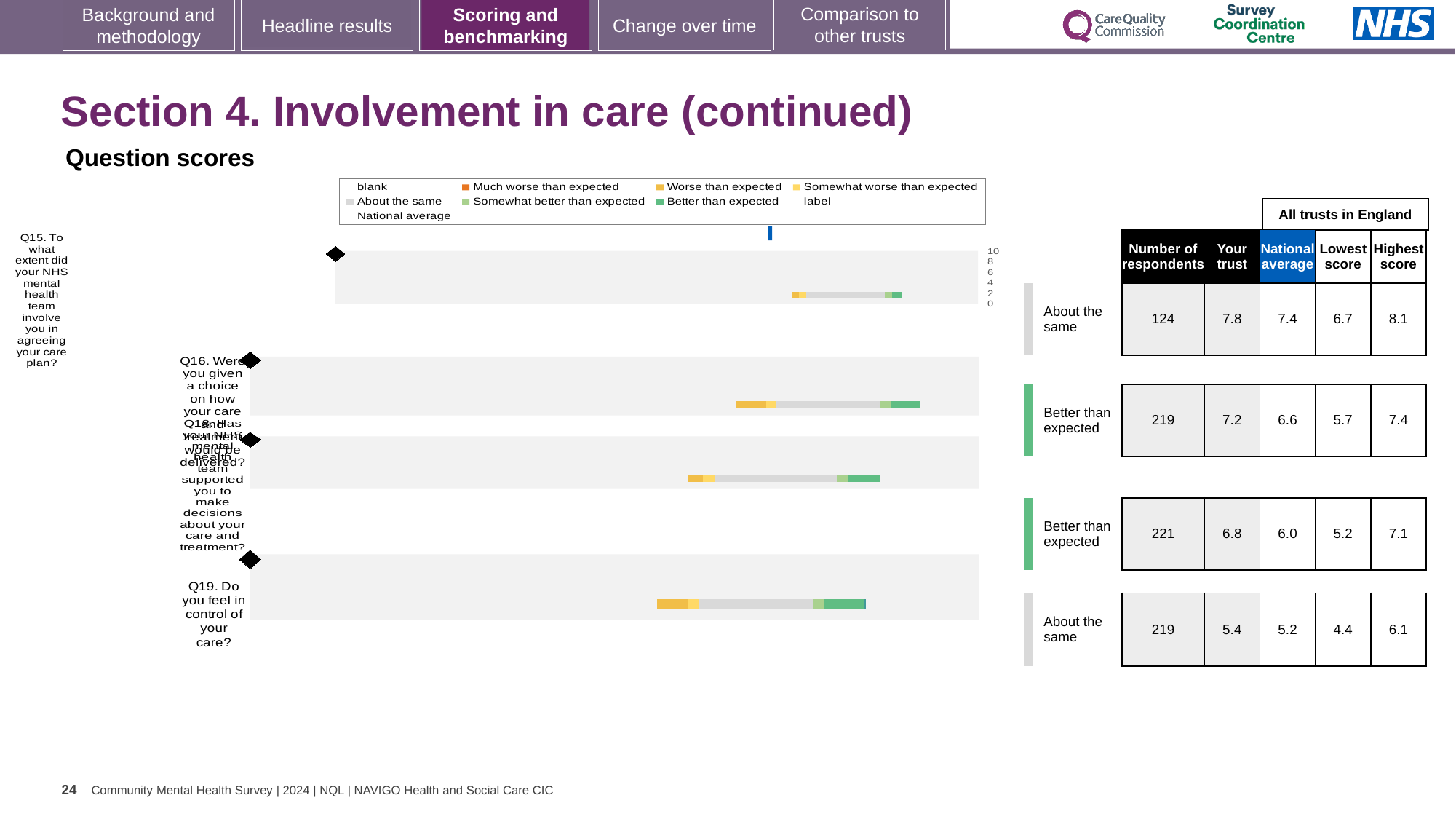
By how much does the 'Your trust' score for Q15 exceed the national average for Q15? 0.4 What kind of chart is used to show the question scores? Bar chart What benchmark category is shown for Q16? Better than expected How many respondents answered Q15 (To what extent did your NHS mental health team involve you in agreeing your care plan?)? 124 What is the 'Your trust' score for Q19 (Do you feel in control of your care?)? 5.4 What is the lowest score among all trusts in England for Q19? 4.4 What is the highest score among all trusts in England for Q18? 7.1 Which question has the highest 'Your trust' score? Q15 How many questions are plotted in the question scores chart? 4 Which question has the lowest 'Your trust' score? Q19 For Q18, which is larger: the 'Your trust' score or the national average? Your trust What is the national average score for Q16 (Were you given a choice on how your care and treatment would be delivered?)? 6.6